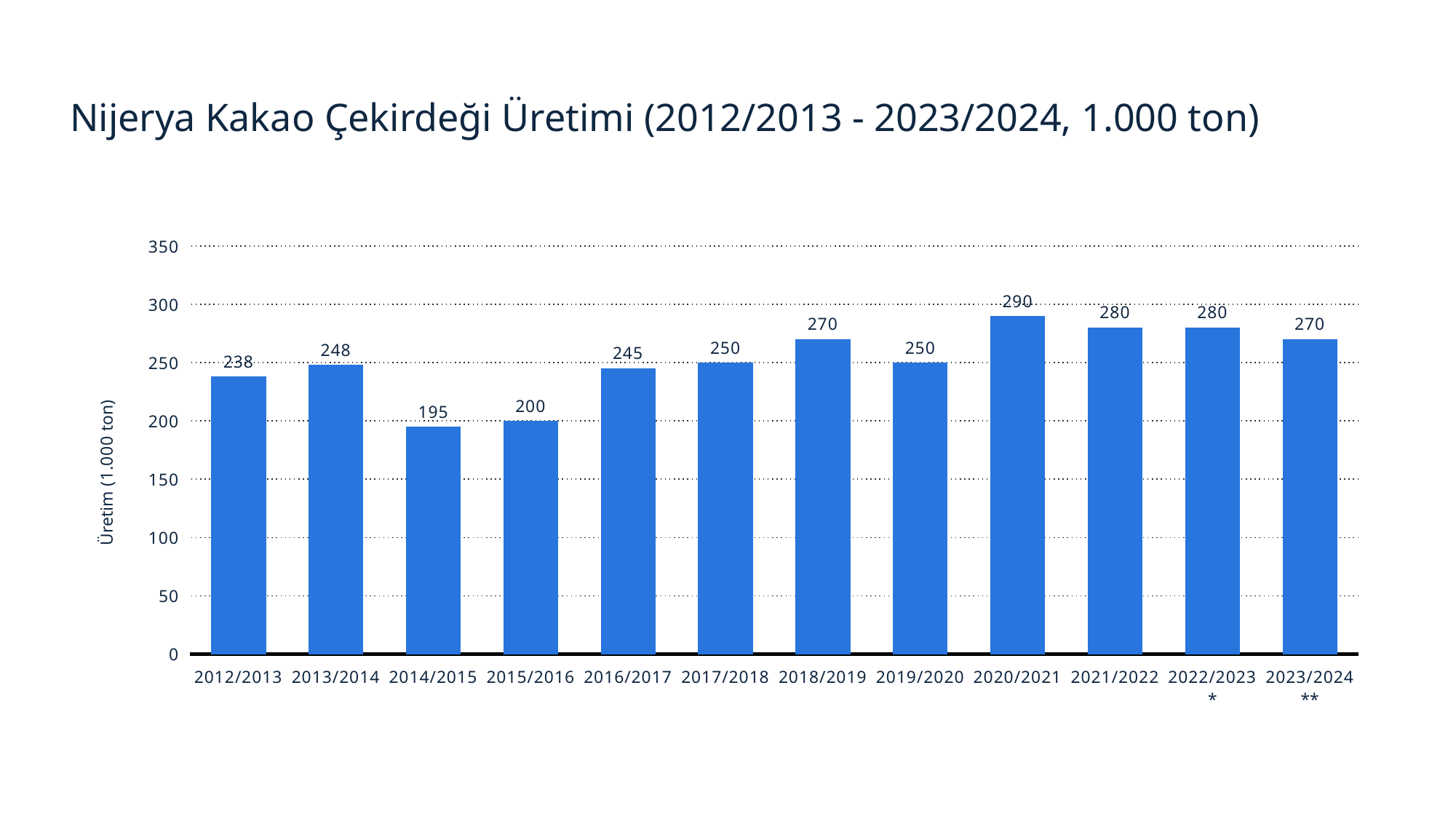
Which season has the highest value? 2020/2021 What is the value for 2020/2021? 290 What is the label of the y axis? Üretim (1.000 ton) What is the value for 2012/2013? 238 Which season has the lowest value? 2014/2015 Do the values rise or fall from 2014/2015 to 2020/2021? rise Is the value for 2015/2016 greater or less than 250? less What kind of chart is shown on the slide? bar chart What is the value for 2014/2015? 195 How many seasons are shown on the x axis? 12 What is the difference between the values for 2020/2021 and 2014/2015? 95 Which is larger, the value for 2013/2014 or the value for 2016/2017? 2013/2014